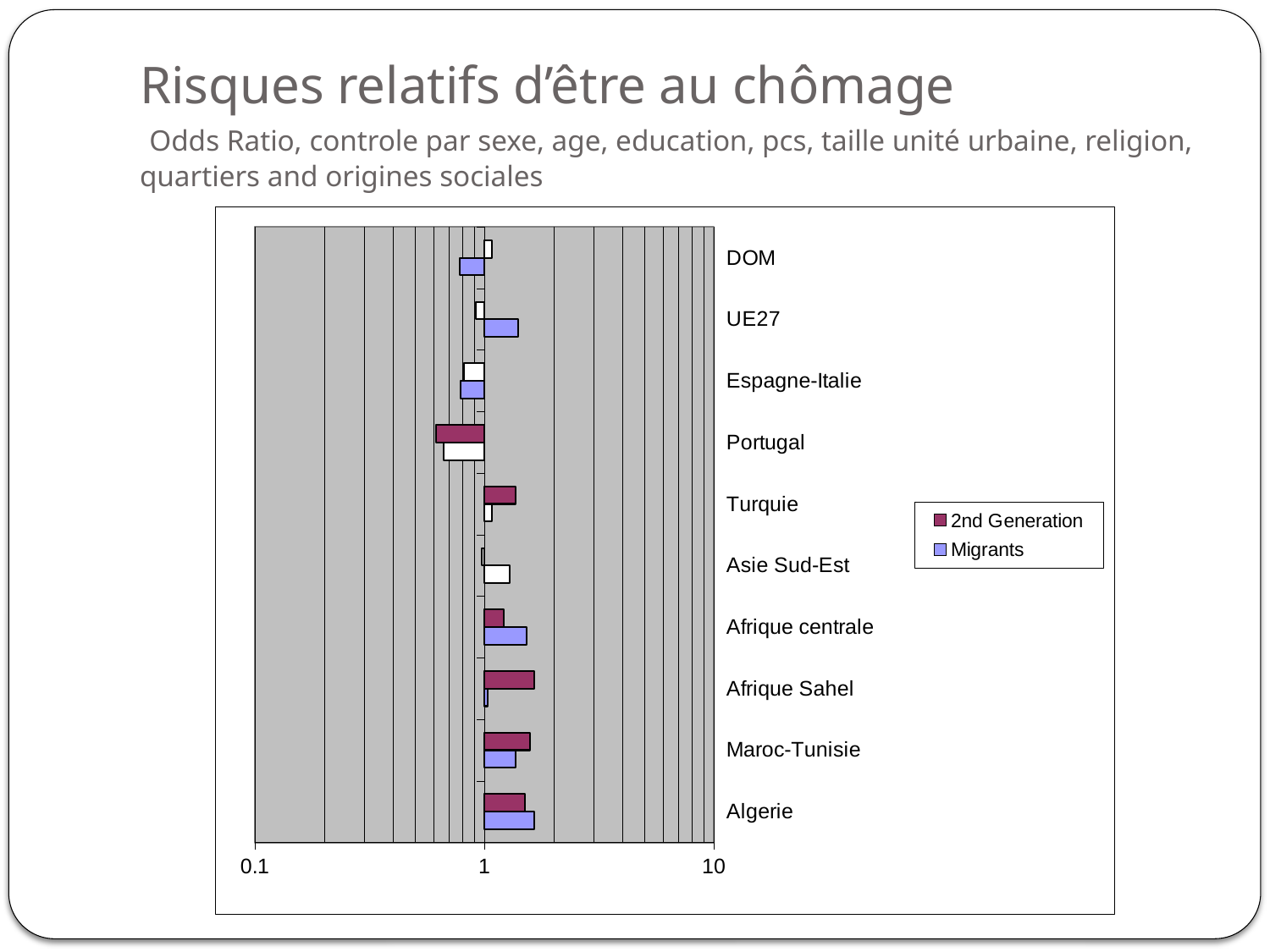
Which series are listed in the legend? 2nd Generation and Migrants How many series does the legend list? 2 Is the Migrants value for Espagne-Italie greater or less than 1? less Is the 2nd Generation value for Afrique Sahel greater or less than 1? greater Is the 2nd Generation value for Portugal greater or less than 1? less Which category has the lowest 2nd Generation value? Portugal What kind of chart is shown on the slide? bar chart What are the lowest and highest values shown on the horizontal axis? 0.1 and 10 For Afrique Sahel, which is larger: the 2nd Generation value or the Migrants value? 2nd Generation How many categories (origin groups) are shown on the chart? 10